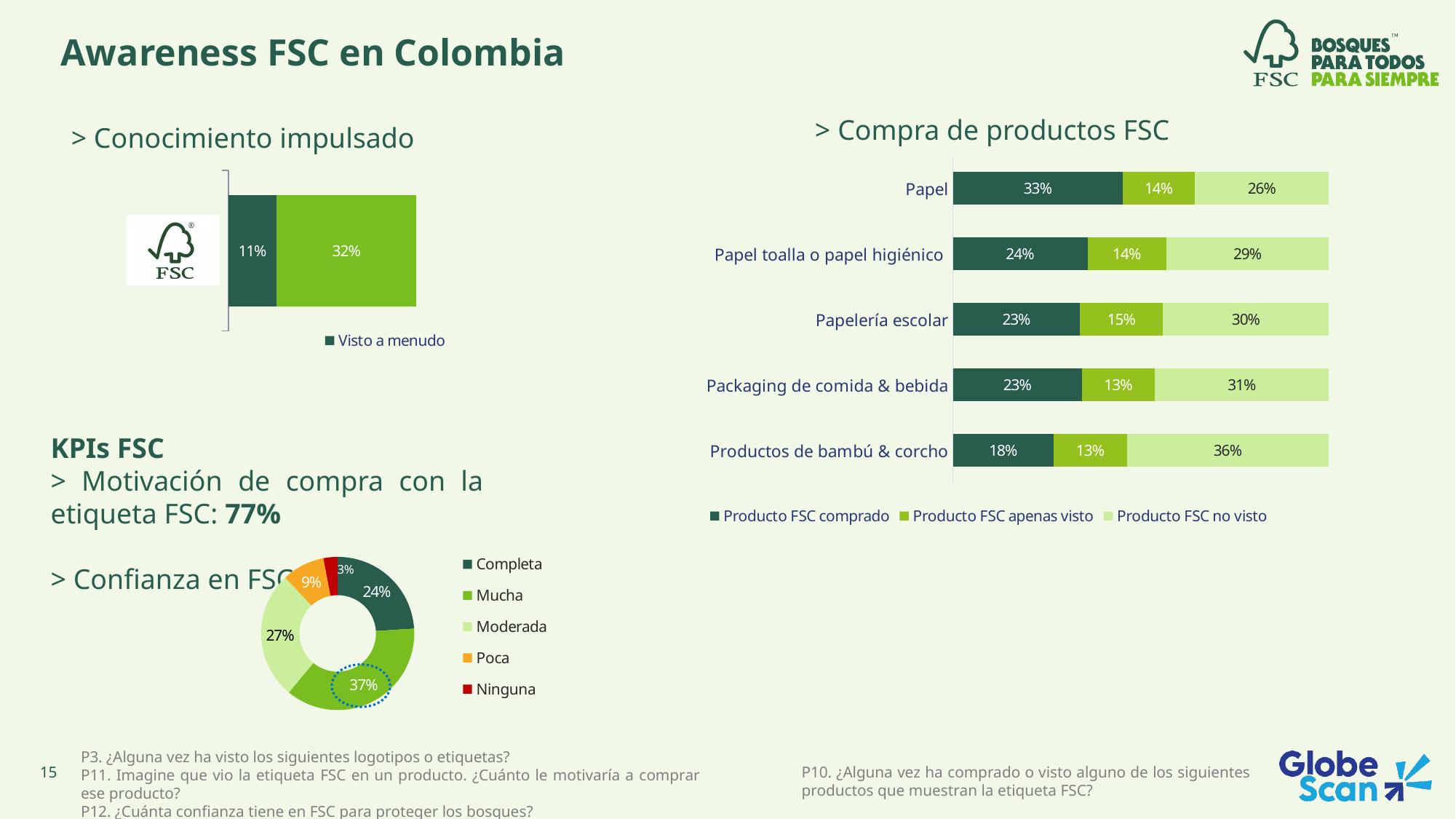
In the 'Compra de productos FSC' chart, what is the 'Producto FSC no visto' value for Productos de bambú & corcho? 36% In the 'Confianza en FSC' chart, what share is labelled 'Mucha'? 37% In the 'Compra de productos FSC' chart, which category has the highest 'Producto FSC comprado' value? Papel In the 'Compra de productos FSC' chart, which category has the lowest 'Producto FSC comprado' value? Productos de bambú & corcho In the 'Compra de productos FSC' chart, what is the difference between the 'Producto FSC comprado' values for Papel and Papel toalla o papel higiénico? 9% In the 'Compra de productos FSC' chart, what is the total of the three segments for Papelería escolar? 68% In the 'Confianza en FSC' chart, which category has the smallest share? Ninguna How many product categories are shown in the 'Compra de productos FSC' chart? 5 In the 'Compra de productos FSC' chart, what percentage of respondents bought an FSC product (Producto FSC comprado) for Papel? 33% In the 'Conocimiento impulsado' chart, what is the value of the dark green 'Visto a menudo' segment? 11% How many series does the legend of the 'Compra de productos FSC' chart list? 3 What kind of chart is the 'Confianza en FSC' chart? Donut (pie) chart